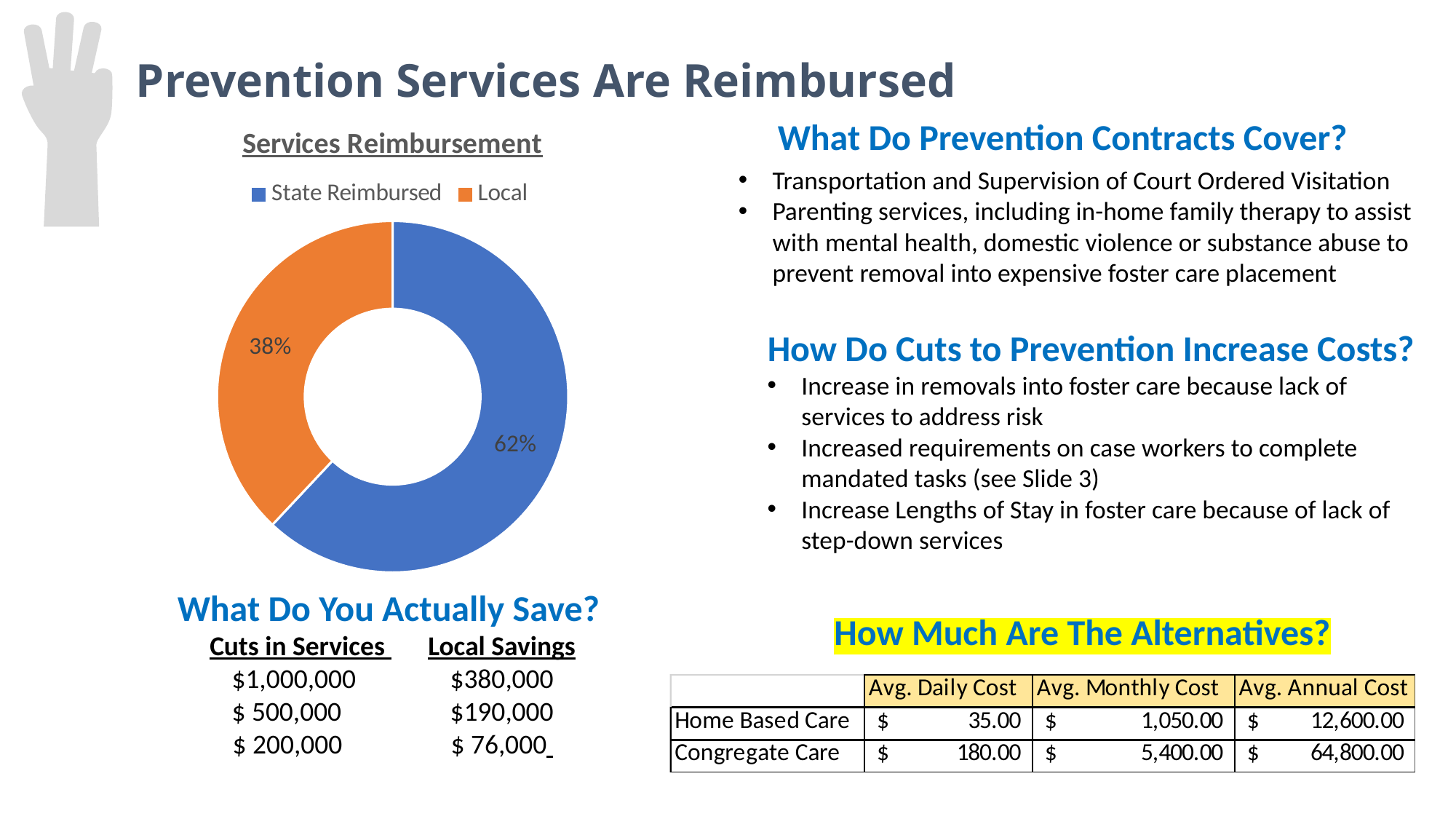
What percentage of the Services Reimbursement chart is State Reimbursed? 62% How many entries does the legend of the Services Reimbursement chart list? 2 What colour represents Local in the Services Reimbursement chart? orange Which category has the smaller share in the Services Reimbursement chart? Local Is the State Reimbursed share larger or smaller than the Local share in the Services Reimbursement chart? larger Is the Local share in the Services Reimbursement chart greater or less than 50%? less What percentage of the Services Reimbursement chart is Local? 38% What is the title of the chart on the slide? Services Reimbursement What kind of chart is the Services Reimbursement chart? doughnut chart How many categories does the Services Reimbursement chart show? 2 Which category has the larger share in the Services Reimbursement chart? State Reimbursed In the Services Reimbursement chart, what is the difference in percentage points between State Reimbursed and Local? 24